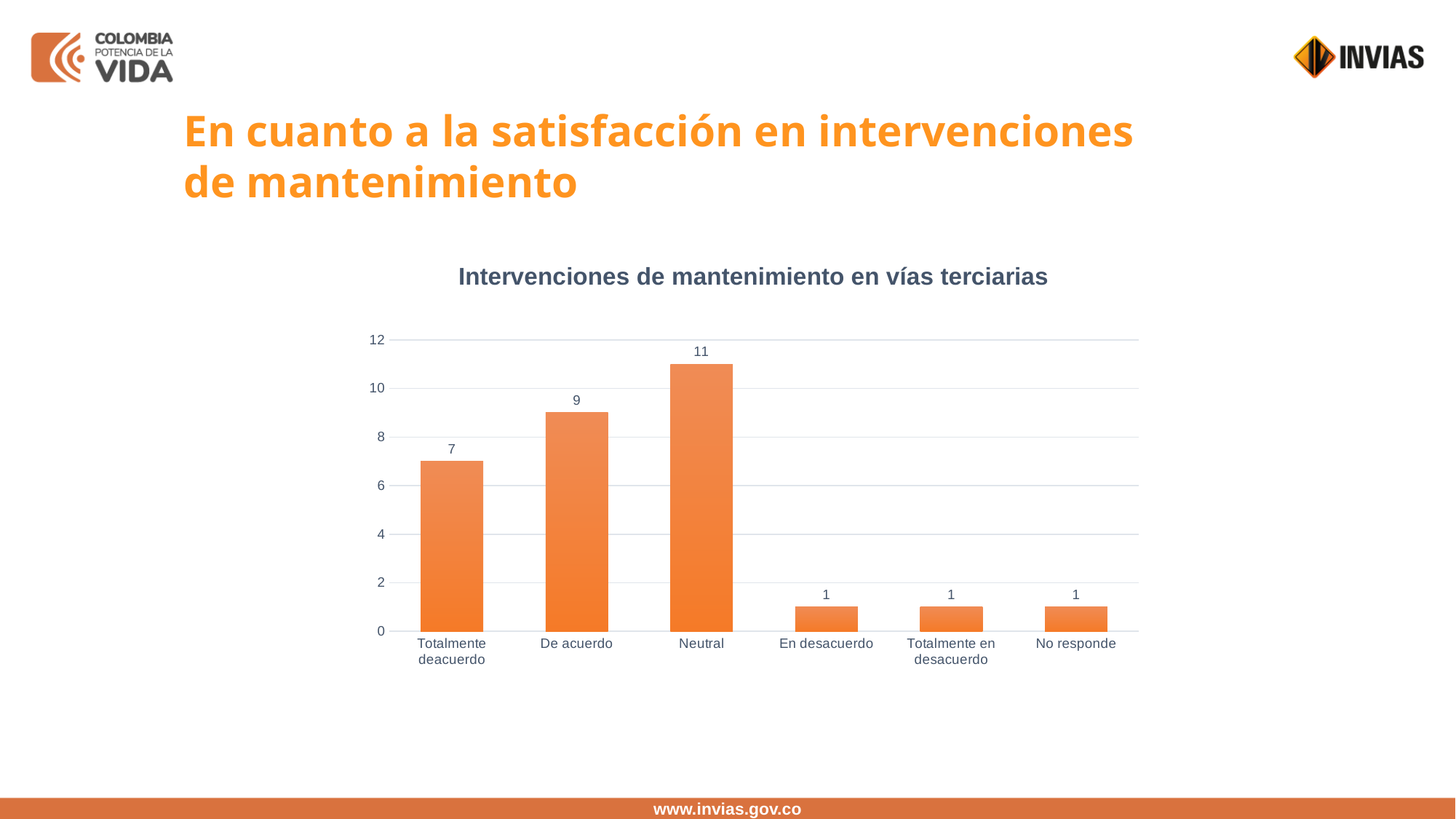
What is the difference between the values for Neutral and De acuerdo? 2 What is the title of the chart? Intervenciones de mantenimiento en vías terciarias What is the value for No responde? 1 What is the value for Neutral? 11 Is the value for Neutral greater or less than 10? greater What is the value for Totalmente deacuerdo? 7 What is the difference between the values for De acuerdo and Totalmente deacuerdo? 2 How many categories are shown on the x axis? 6 What is the value for De acuerdo? 9 Which is larger, the value for De acuerdo or the value for Totalmente deacuerdo? De acuerdo Which category has the highest value? Neutral What kind of chart is shown? bar chart